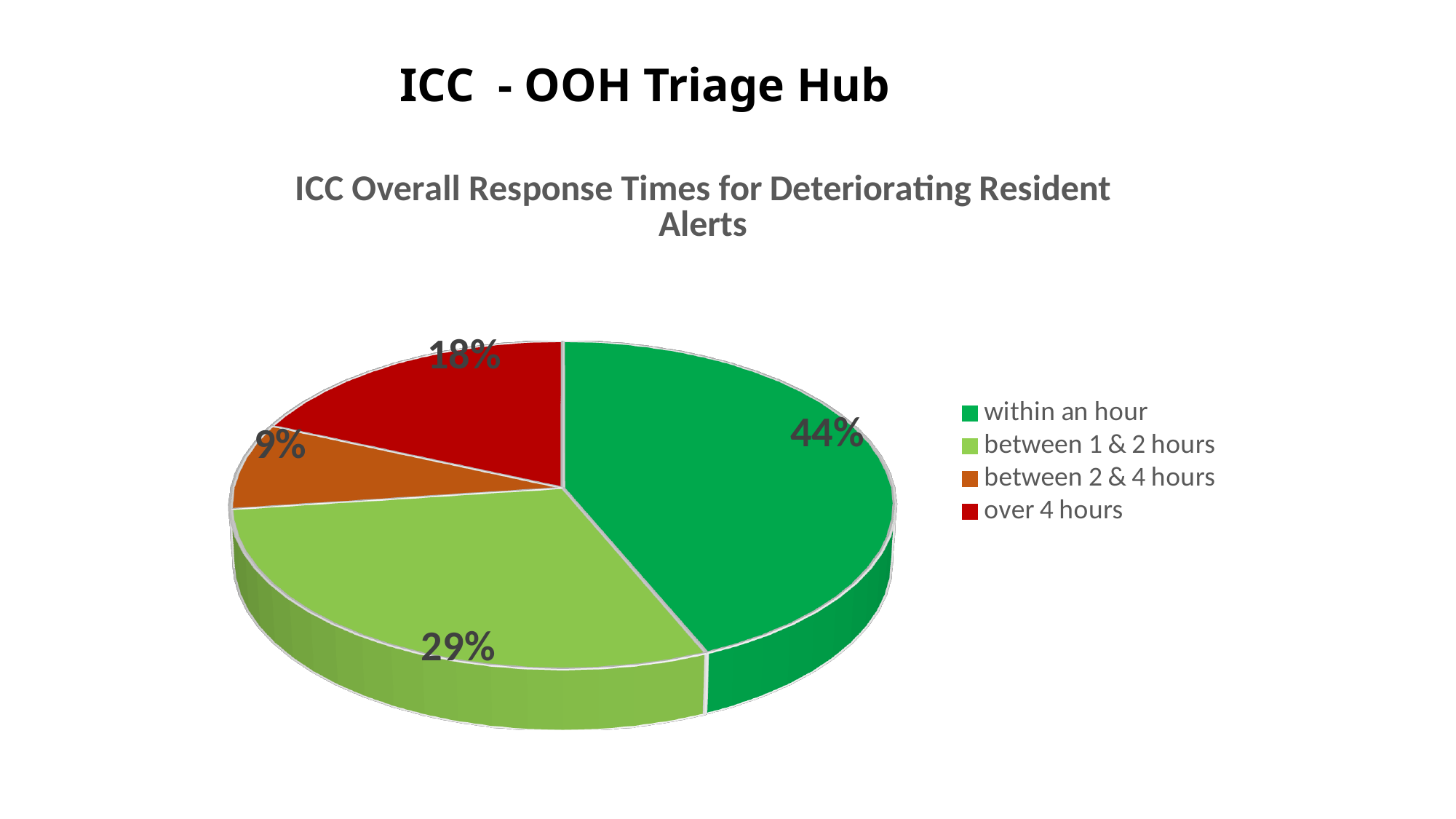
What kind of chart is shown on the slide? pie chart Which category has the largest slice of the pie? within an hour How many categories does the pie chart show? 4 What percentage is shown for 'between 2 & 4 hours'? 9% What percentage is shown for 'over 4 hours'? 18% Which is larger, the slice for 'over 4 hours' or the slice for 'between 2 & 4 hours'? over 4 hours What colour is the slice for 'over 4 hours'? red What is the title of the chart? ICC Overall Response Times for Deteriorating Resident Alerts What share of the pie is labelled 'within an hour'? 44% Which category has the smallest slice of the pie? between 2 & 4 hours What percentage is shown for 'between 1 & 2 hours'? 29% What is the difference in percentage points between 'within an hour' and 'between 1 & 2 hours'? 15